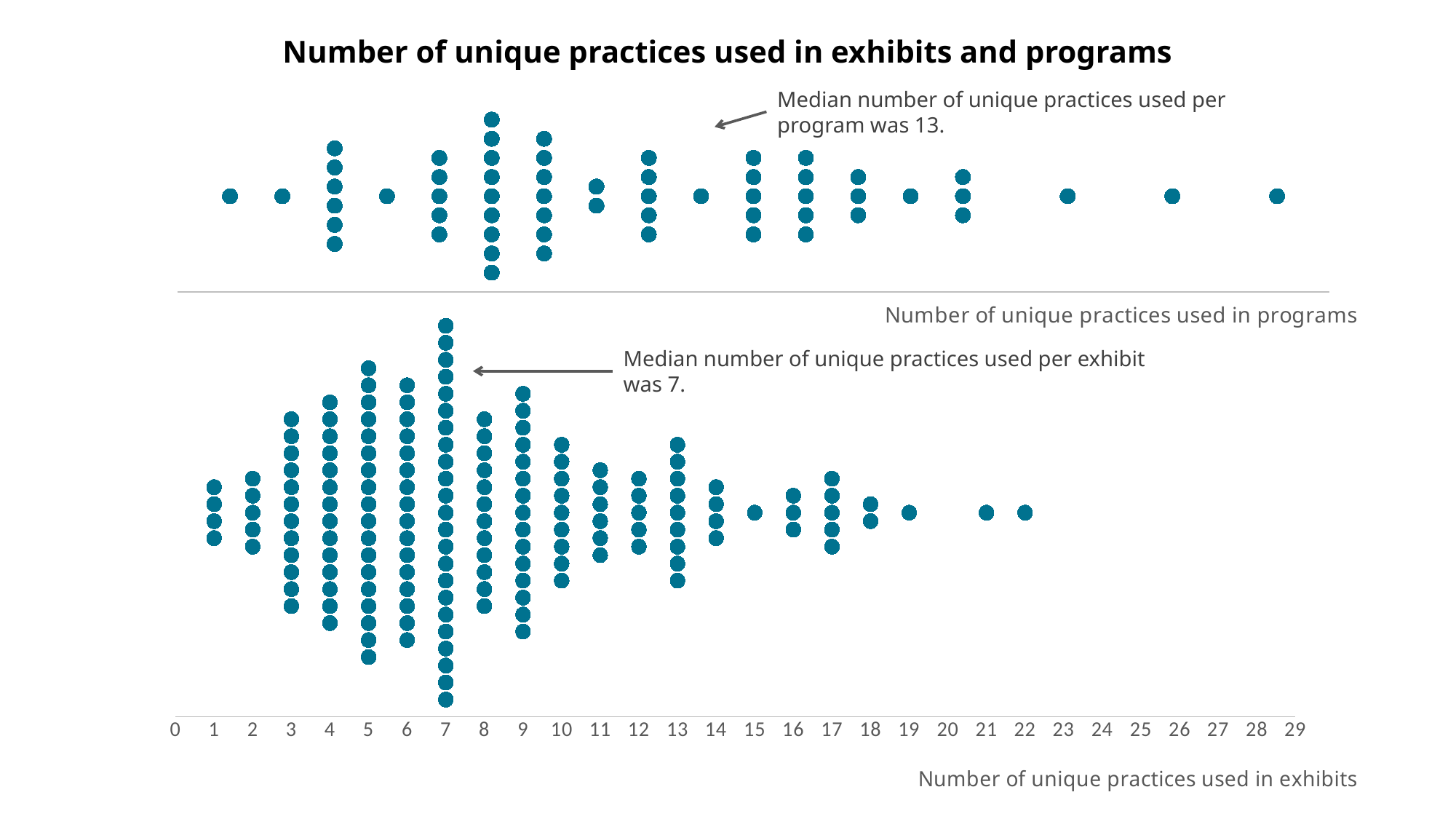
In the exhibits panel (bottom), how many dots are at 15 unique practices? 1 What kind of chart is shown on the slide? dot plot In the exhibits panel (bottom), how many dots are at 18 unique practices? 2 In the exhibits panel (bottom), are there more dots at 5 unique practices or at 14 unique practices? 5 According to the annotation, what was the median number of unique practices used per program? 13 In the exhibits panel (bottom), is the number of dots at 7 unique practices greater or less than 20? greater In the exhibits panel (bottom), which number of unique practices has the most dots? 7 What is the title of the chart? Number of unique practices used in exhibits and programs In the exhibits panel (bottom), what is the largest number of unique practices used by any exhibit? 22 In the exhibits panel (bottom), what is the smallest number of unique practices used by any exhibit? 1 What is the highest value labeled on the x axis? 29 According to the annotation, what was the median number of unique practices used per exhibit? 7